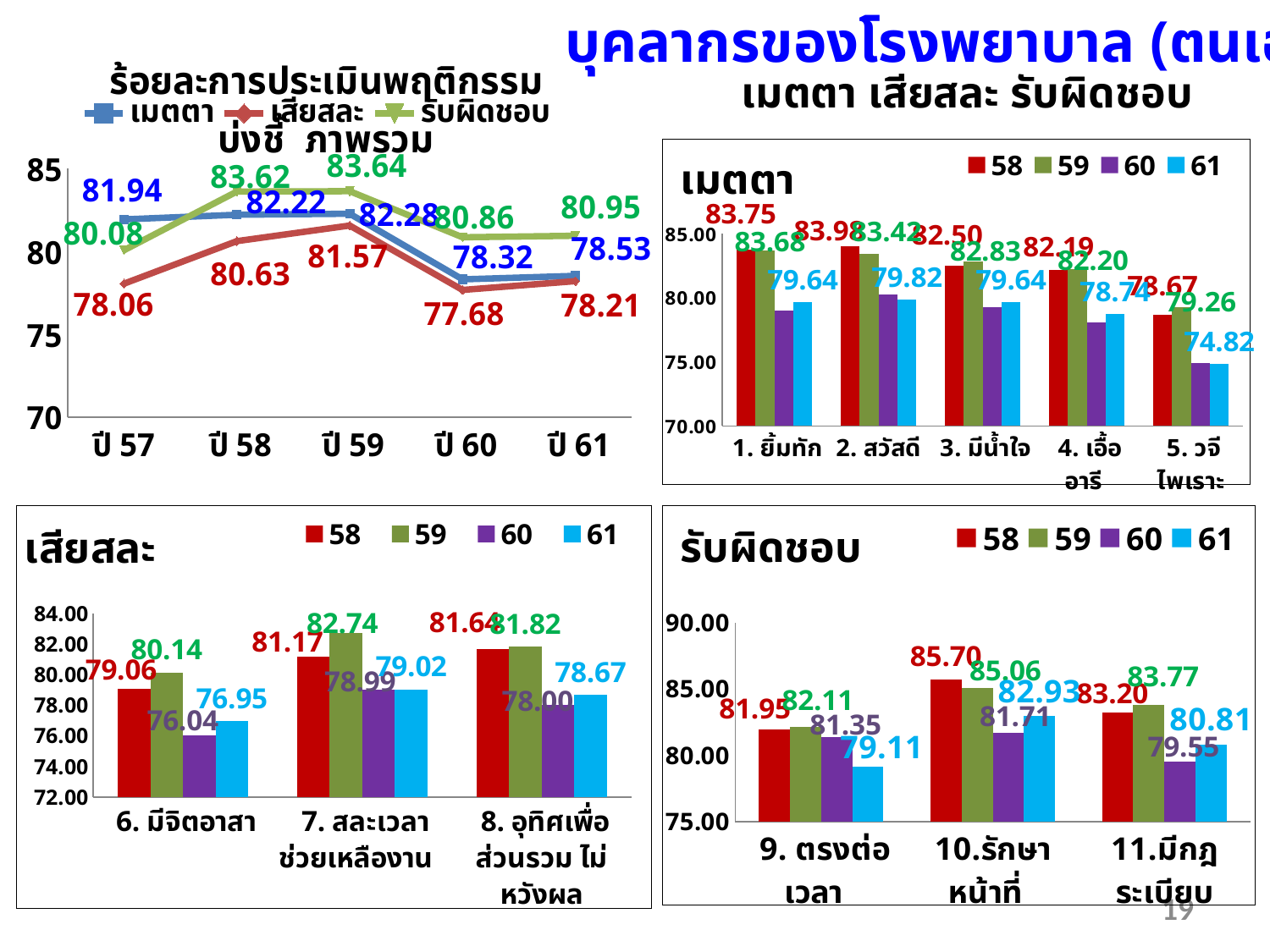
What kind of chart is the chart at the top left of the slide? line chart In the เสียสละ bar chart, which is larger for 7. สละเวลาช่วยเหลืองาน: series 58 or series 59? 59 In the เมตตา bar chart, which category has the lowest value for series 61? 5. วจีไพเราะ In the รับผิดชอบ bar chart, what is the value of series 58 for 10.รักษาหน้าที่? 85.70 In the เมตตา bar chart, what is the value of series 58 for 1. ยิ้มทัก? 83.75 In the line chart at the top left, what is the value of รับผิดชอบ for ปี 58? 83.62 In the line chart at the top left, what is the value of เสียสละ for ปี 59? 81.57 In the line chart at the top left, how many series does the legend list? 3 In the เสียสละ bar chart, what is the value of series 60 for 6. มีจิตอาสา? 76.04 In the line chart at the top left, which year has the highest value for เมตตา? ปี 59 In the line chart at the top left, what is the difference between รับผิดชอบ and เสียสละ in ปี 57? 2.02